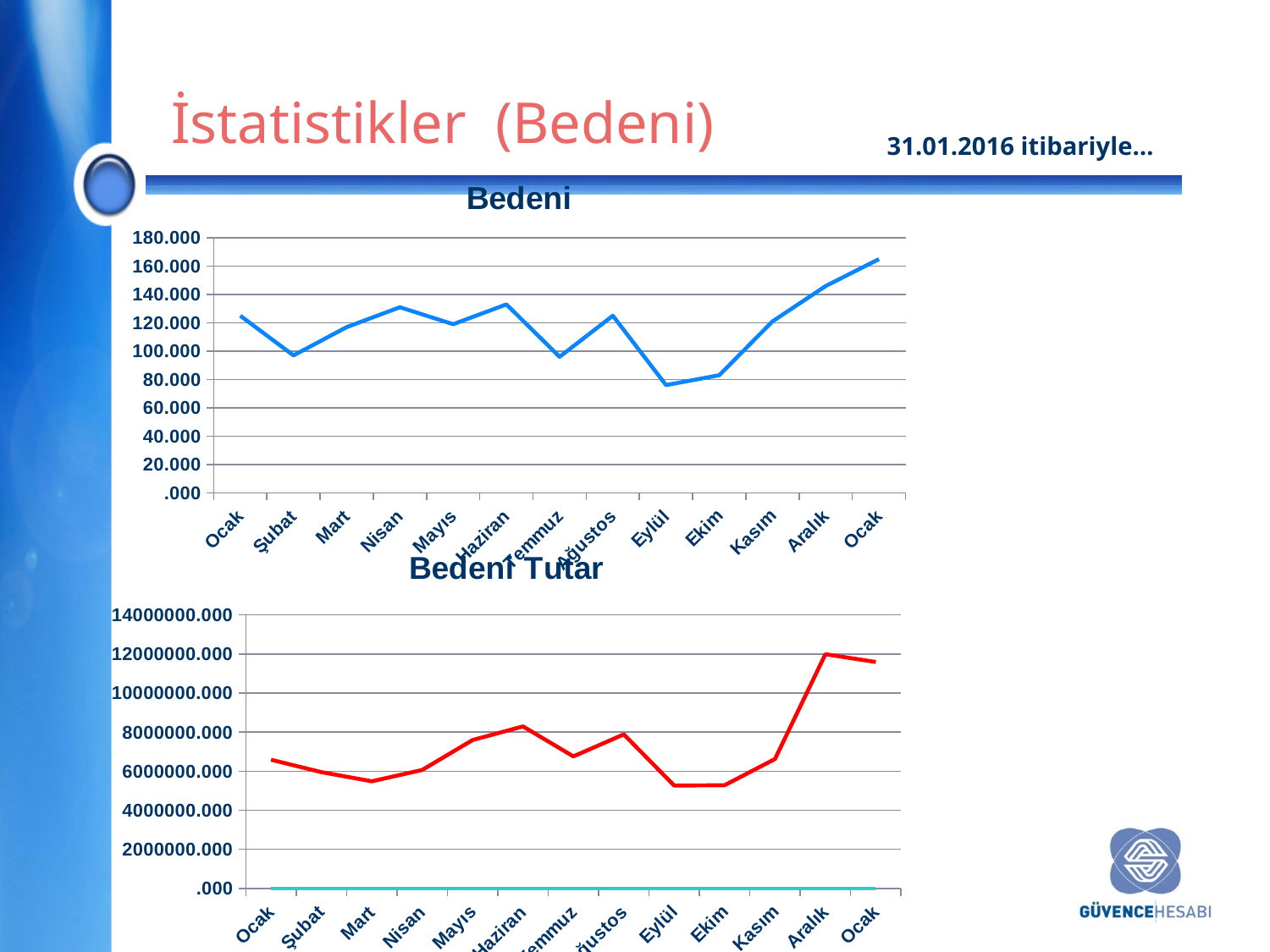
In the 'Bedeni' chart, which is larger, the value for Nisan or the value for Mayıs? Nisan What kind of chart is the 'Bedeni Tutar' chart at the bottom of the slide? line chart In the 'Bedeni' chart, how many points are plotted along the x axis? 13 In the 'Bedeni Tutar' chart, is the value for Aralık greater or less than 10000000.000? greater In the 'Bedeni' chart, which month has the highest value? Ocak (the last point) In the 'Bedeni' chart, is the value for the final Ocak greater or less than 160.000? greater In the 'Bedeni' chart, is the value for Eylül greater or less than 80.000? less In the 'Bedeni Tutar' chart, which is larger, the value for Haziran or the value for Temmuz? Haziran In the 'Bedeni' chart, do the values rise or fall from Eylül to the final Ocak? rise In the 'Bedeni Tutar' chart, which month has the highest value? Aralık What kind of chart is the 'Bedeni' chart at the top of the slide? line chart In the 'Bedeni' chart, which month has the lowest value? Eylül